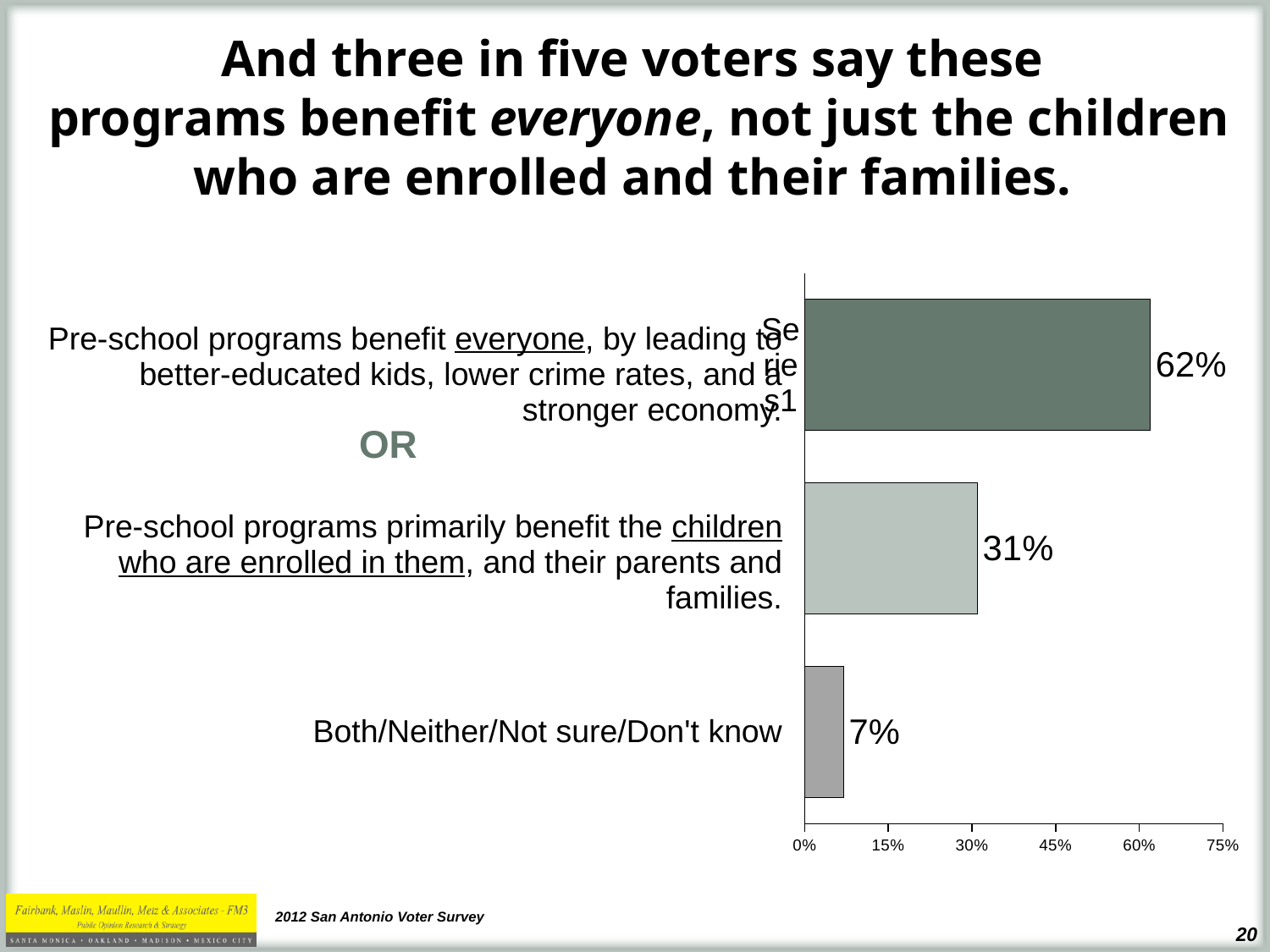
What percentage of voters say pre-school programs benefit everyone? 62% What type of chart is shown on the slide? Bar chart What is the value for Both/Neither/Not sure/Don't know? 7% Which response has the lowest percentage? Both/Neither/Not sure/Don't know What percentage of voters say pre-school programs primarily benefit the children who are enrolled in them? 31% What is the difference between the percentage saying programs benefit everyone and the percentage saying they primarily benefit enrolled children? 31% Is the value for 'benefit everyone' greater or less than 60%? greater How many response categories are shown in the chart? 3 What is the maximum value shown on the horizontal axis? 75% Which response has the highest percentage? Pre-school programs benefit everyone Is the value for Both/Neither/Not sure/Don't know greater or less than 15%? less Which is larger: the share saying programs primarily benefit enrolled children, or the share answering Both/Neither/Not sure/Don't know? Primarily benefit enrolled children